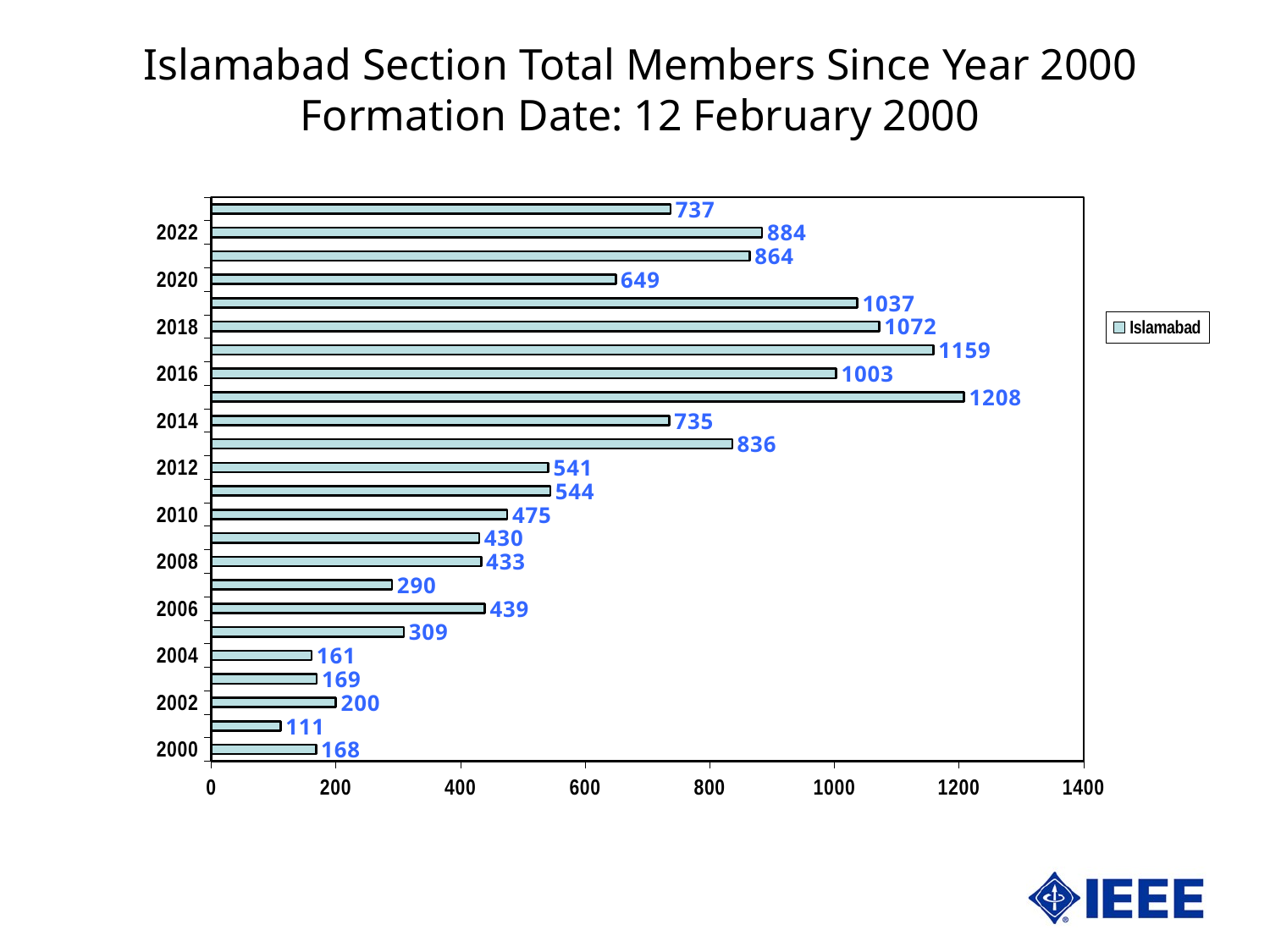
What is the name of the series in the legend? Islamabad How many bars are plotted on the chart? 24 What is the value for 2010? 475 What is the value for 2018? 1072 What is the difference between the values for 2016 and 2014? 268 What is the value for 2022? 884 What type of chart is shown on the slide? bar chart Which is larger, the value for 2020 or the value for 2012? 2020 What is the smallest value shown on the chart? 111 How many series does the legend list? 1 What is the largest value shown on the chart? 1208 What is the value for 2000? 168